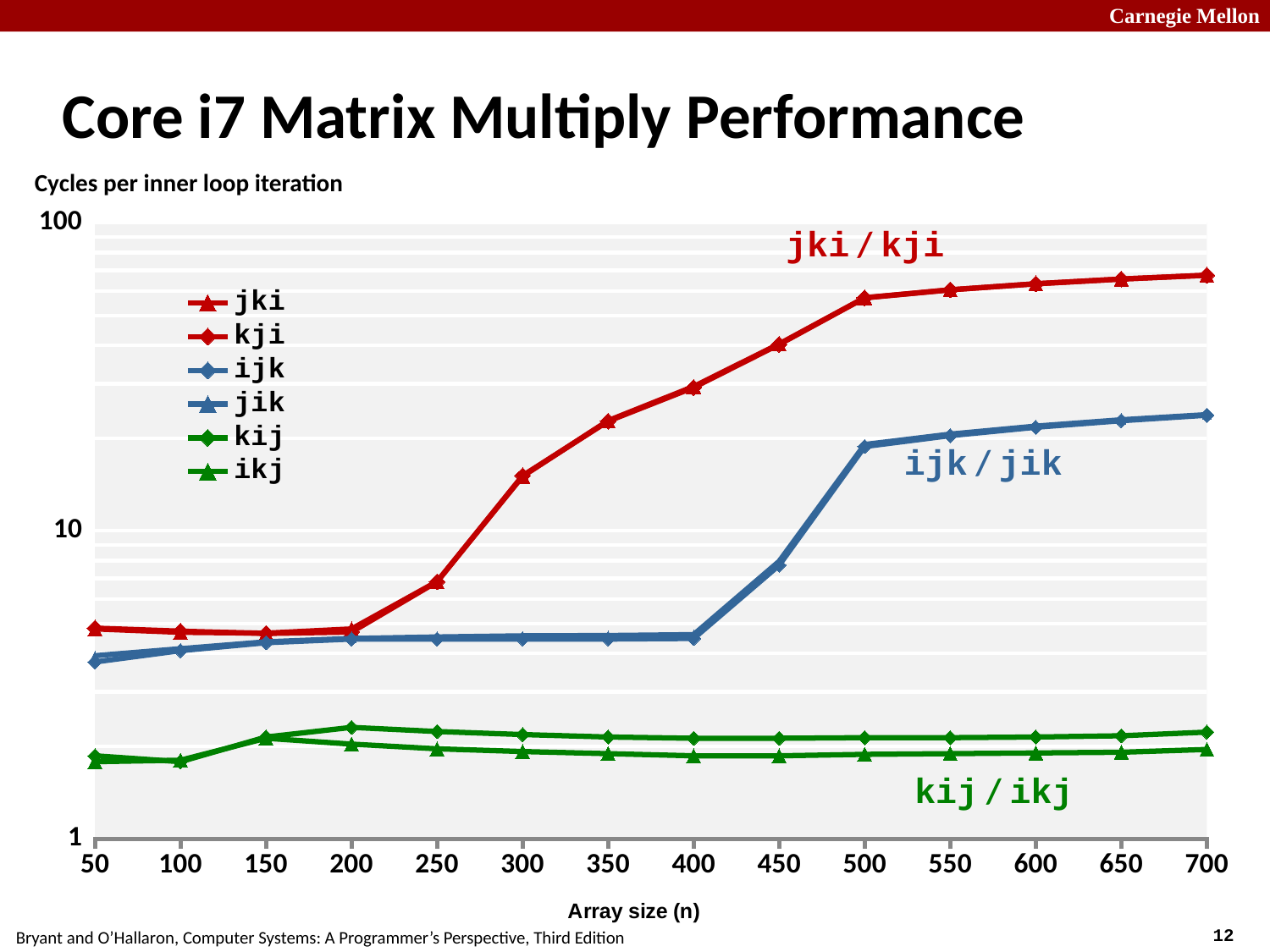
At n=300, which has the larger value, jki or ijk? jki Is the value for jki at n=50 greater or less than 10? less How many array-size values are marked along the x axis? 14 Is the value for kij at n=700 greater or less than 10? less How many series does the legend list? 6 Between n=400 and n=500, does the value for ijk rise or fall? rise What is the x-axis title of the chart? Array size (n) Is the value for jki at n=700 greater or less than 10? greater Which loop-ordering pair, as labelled on the chart, has the highest cycles per inner loop iteration at n=700? jki/kji What quantity does the y axis measure, according to the label above the chart? Cycles per inner loop iteration What kind of chart is shown on the slide? line chart